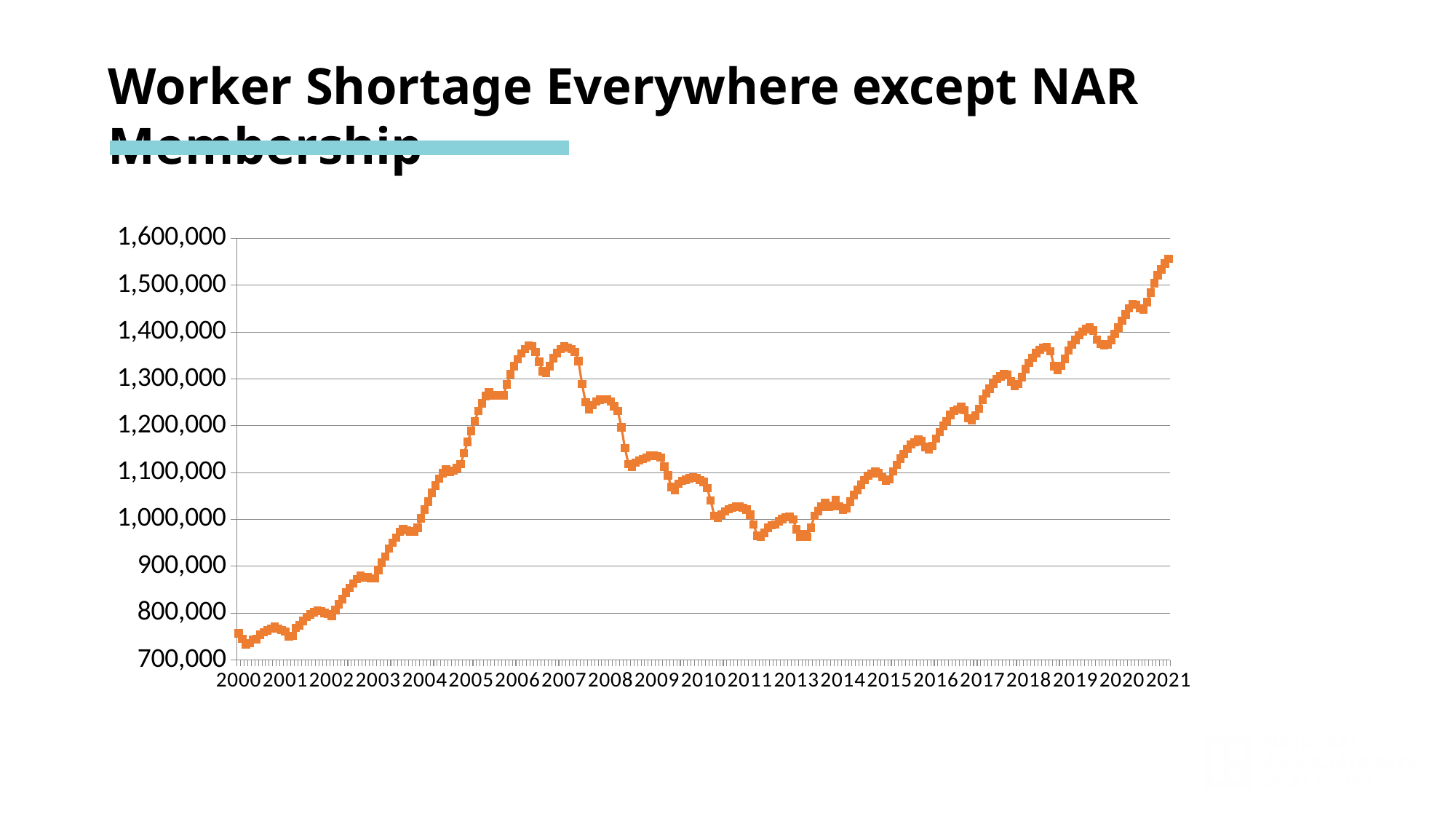
Is the lowest value around 2012 greater or less than 1,000,000? less What is the highest value shown on the y axis? 1,600,000 Is the value at the end of the series in 2021 greater or less than 1,500,000? greater Does the line rise or fall between 2012 and 2021? rise What is the title of the slide containing the chart? Worker Shortage Everywhere except NAR Membership Does the line rise or fall between 2007 and 2012? fall Is the peak value around 2006 greater or less than 1,300,000? greater In which year does the line reach its highest point? 2021 What kind of chart is shown on the slide? line chart How many year labels are shown along the x axis of the chart? 22